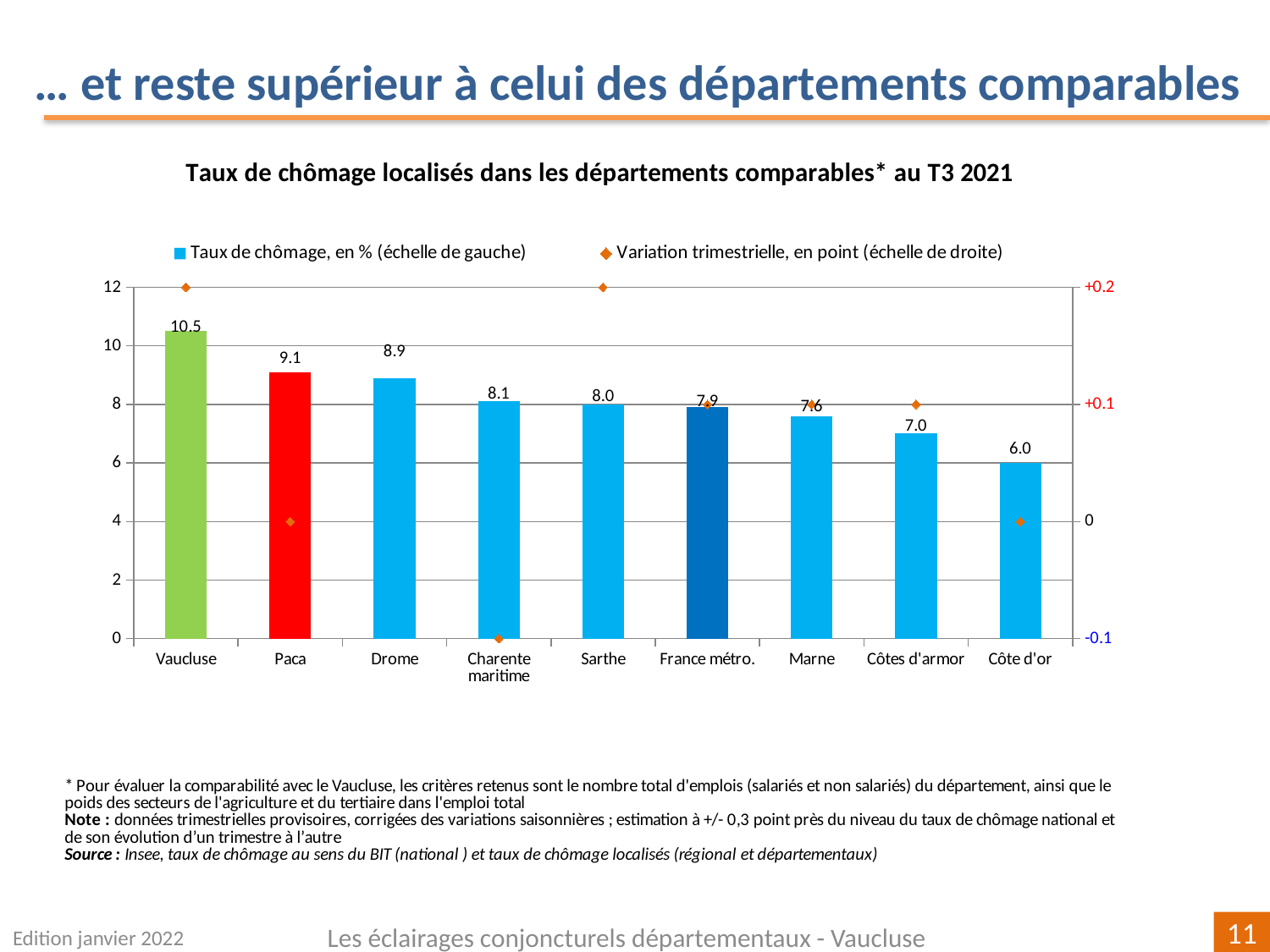
What is the quarterly variation shown for Sarthe on the right axis? +0.2 Which has a higher unemployment rate, Drome or Sarthe? Drome How many series does the legend list? 2 What is the quarterly variation (variation trimestrielle) shown for Charente maritime on the right axis? -0.1 What is the unemployment rate shown for Côtes d'armor? 7.0 What kind of chart is used to show the unemployment rates? Bar chart What is the difference between the unemployment rate of Vaucluse and that of Paca? 1.4 What is the unemployment rate (taux de chômage) shown for Vaucluse? 10.5 Which department has the highest unemployment rate on the chart? Vaucluse Which category has the lowest unemployment rate on the chart? Côte d'or How many categories are shown on the x axis of the chart? 9 What is the unemployment rate shown for France métro.? 7.9